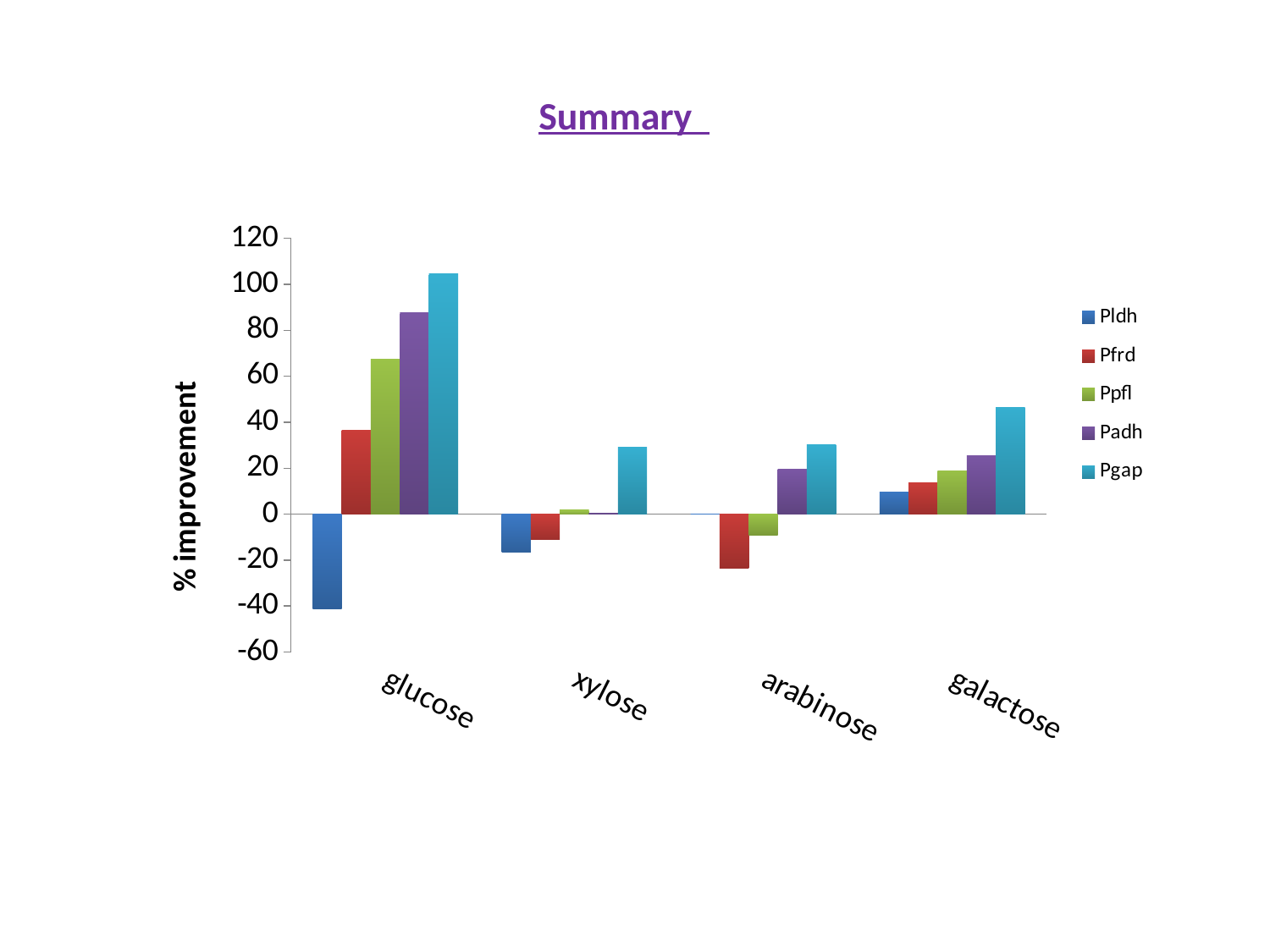
How many series does the legend list? 5 Which series has the lowest value for arabinose? Pfrd For galactose, which is larger: Padh or Pgap? Pgap Is the value for Pgap at galactose greater or less than 40? greater What is the label on the y axis? % improvement Is the value for Pgap at glucose greater or less than 100? greater Which series has the lowest value for glucose? Pldh Which series has the highest value for glucose? Pgap Which is larger: Pfrd at glucose or Pfrd at galactose? Pfrd at glucose What kind of chart is shown on the slide? bar chart How many sugar categories are shown on the x axis? 4 Is the value for Pldh at glucose greater or less than -20? less